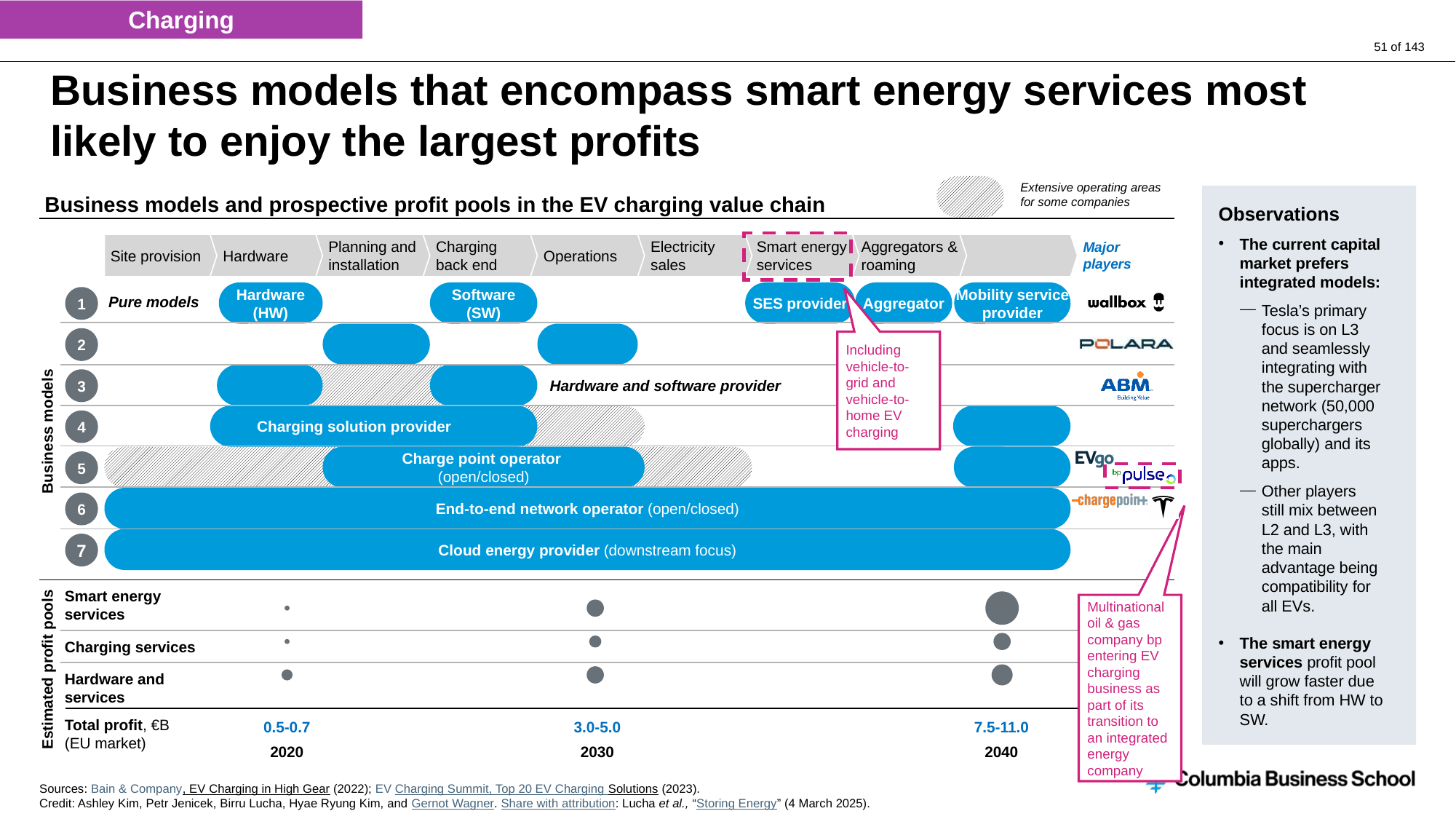
In the estimated profit pools section, what is the total profit (EU market) shown for 2030? 3.0-5.0 How many numbered business models are listed in the diagram? 7 In the estimated profit pools section, which year shows the smallest total profit range? 2020 How many years are shown along the bottom of the estimated profit pools section? 3 How many profit pool categories are listed in the estimated profit pools section? 3 In the estimated profit pools section, is the total profit range larger for 2030 or for 2020? 2030 What unit is given for total profit in the estimated profit pools section? €B In the estimated profit pools section, which profit pool has the largest bubble in 2040? Smart energy services In the estimated profit pools section, what is the total profit (EU market) shown for 2020? 0.5-0.7 In the estimated profit pools section, what is the total profit (EU market) shown for 2040? 7.5-11.0 In the estimated profit pools section, does total profit rise or fall from 2020 to 2040? rise In the estimated profit pools section, which year shows the largest total profit range? 2040